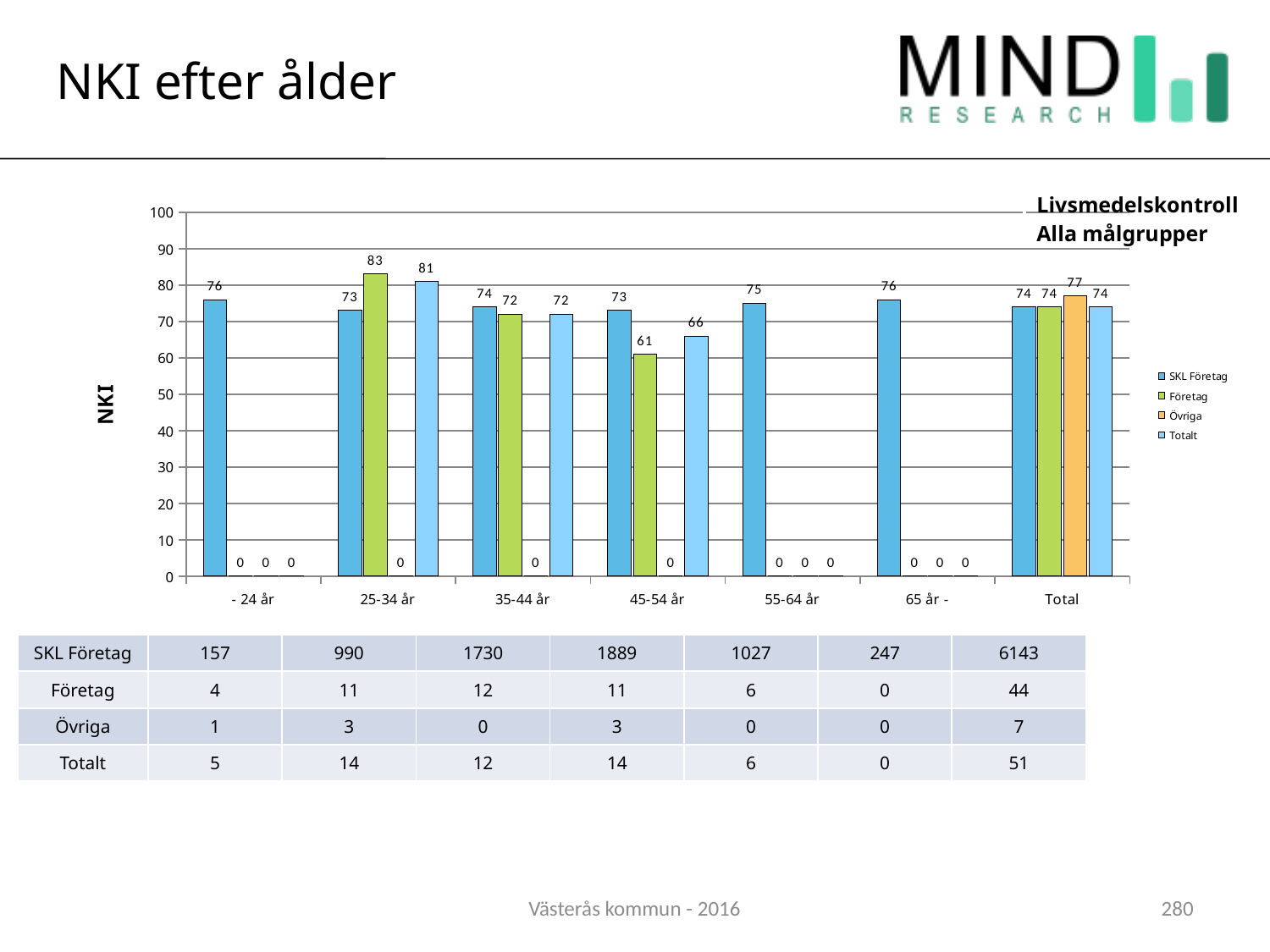
What is the Övriga value in the Total category? 77 What is the SKL Företag value for the 55-64 år age group? 75 Which is larger for the 45-54 år age group: the SKL Företag value or the Företag value? SKL Företag What kind of chart is shown on the slide? Bar chart What is the label on the vertical axis of the chart? NKI Which age group has the highest Företag value? 25-34 år What is the difference between the Företag value and the SKL Företag value for the 25-34 år age group? 10 What is the Totalt value for the 45-54 år age group? 66 How many series does the legend list? 4 What is the Företag value for the 25-34 år age group? 83 Among the age groups with a non-zero Totalt value, which has the lowest Totalt value? 45-54 år How many age categories (including Total) are shown on the x axis? 7